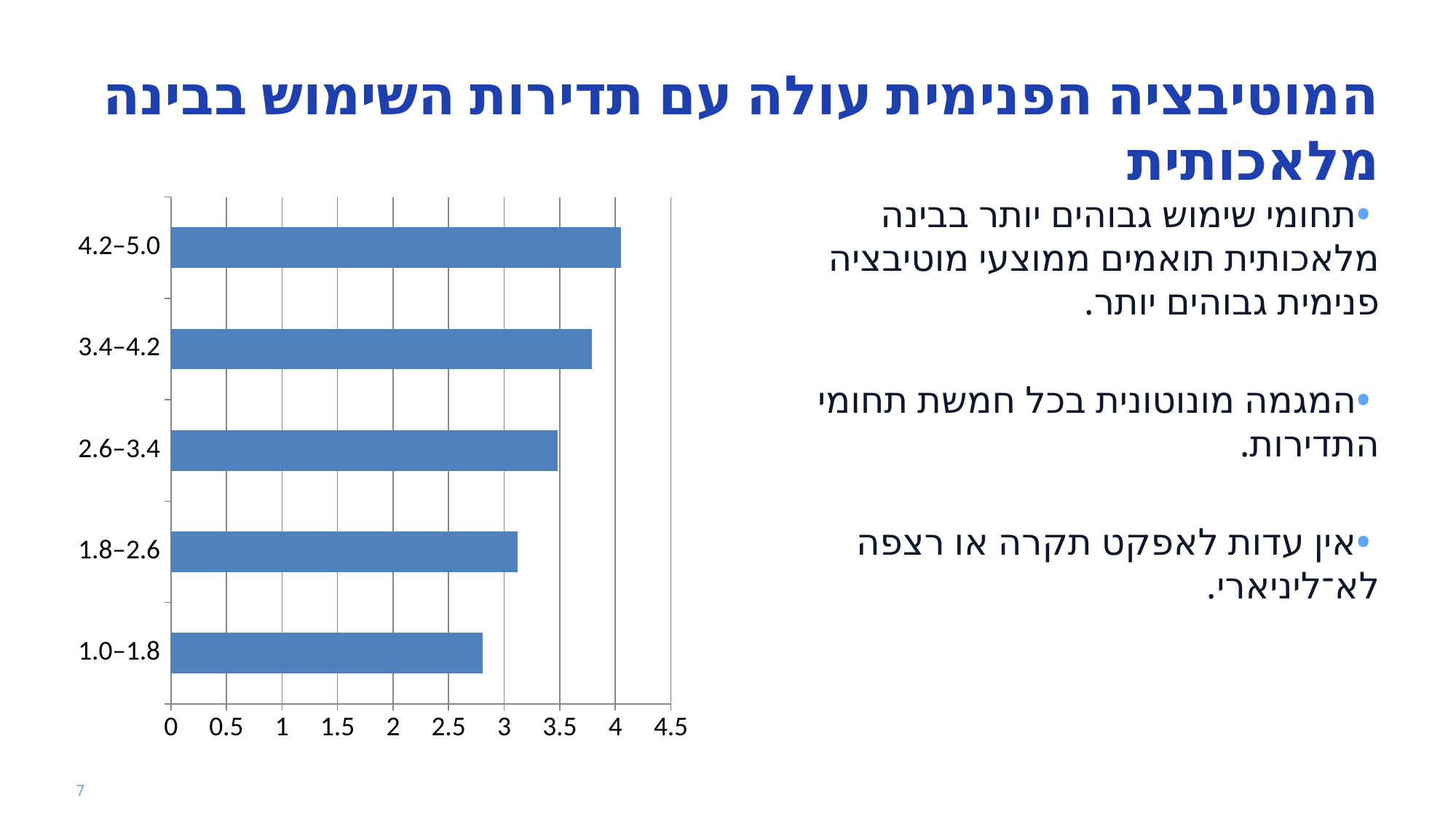
Is the value for 3.4–4.2 greater or less than 3.5? greater Is the value for 4.2–5.0 greater or less than 3.5? greater Which category has the highest value? 4.2–5.0 Do the bar values rise or fall as the category ranges increase from 1.0–1.8 to 4.2–5.0? rise What is the maximum value shown on the horizontal axis? 4.5 What kind of chart is shown on the slide? bar chart Which has the larger value, the 4.2–5.0 category or the 1.0–1.8 category? 4.2–5.0 Which has the larger value, the 3.4–4.2 category or the 1.8–2.6 category? 3.4–4.2 Is the value for 1.0–1.8 greater or less than 2.5? greater Which category has the lowest value? 1.0–1.8 How many categories (bars) does the chart show? 5